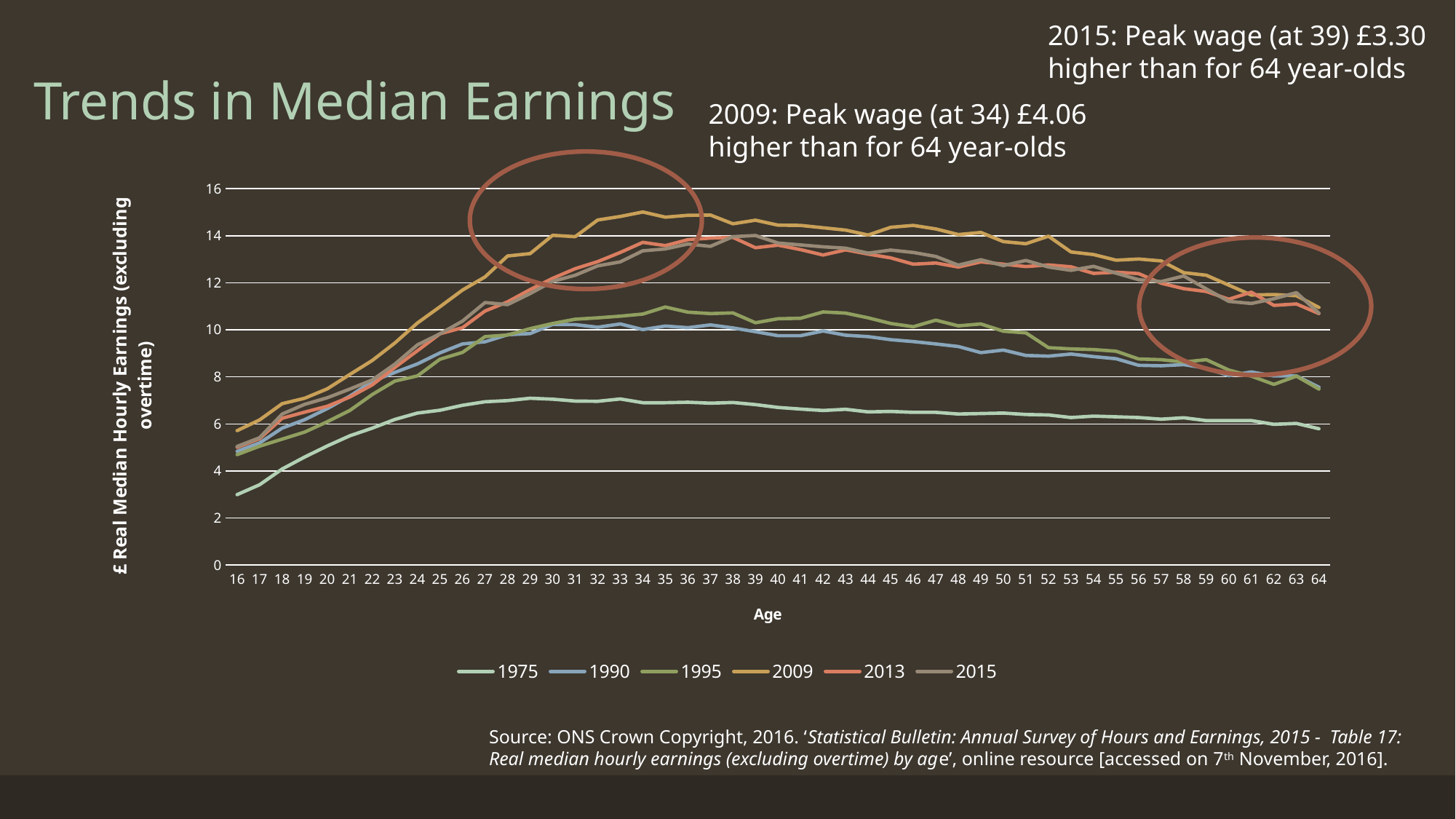
Do the values of the 1975 series rise or fall between ages 16 and 30? rise What kind of chart is shown on the slide? line chart Is the value for the 1975 series at age 16 greater or less than 4? less How many ages are plotted along the x axis? 49 Is the value for the 1975 series at age 30 greater or less than 8? less How many series does the legend list? 6 What is the title of the y axis? £ Real Median Hourly Earnings (excluding overtime) Which series has the lowest values across the whole age range? 1975 Is the value for the 2009 series at age 34 greater or less than 14? greater Which series reaches the highest value on the chart? 2009 Do the values of the 2009 series rise or fall between ages 50 and 64? fall Which is larger at age 40: the 2009 series or the 1990 series? 2009